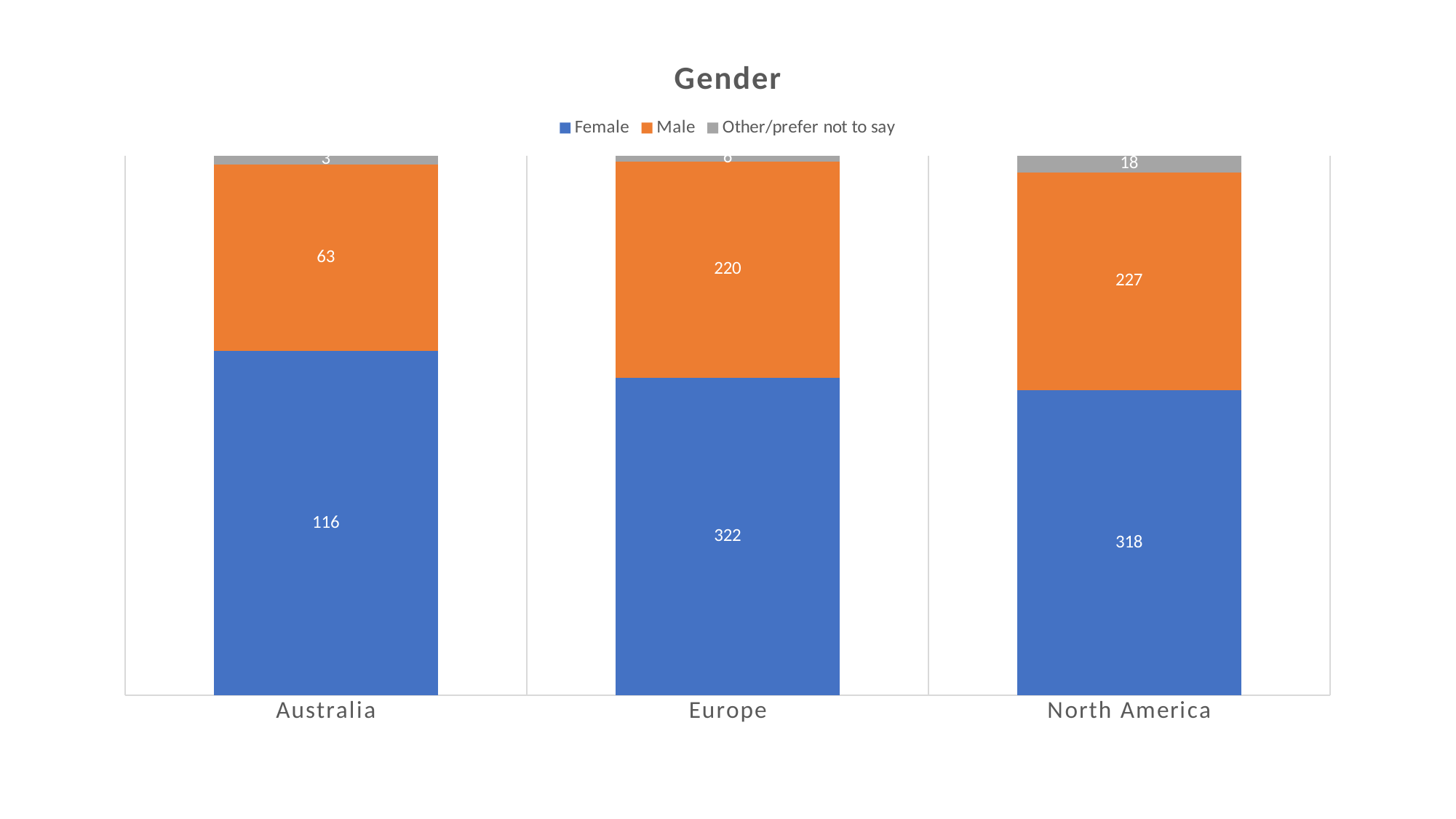
How many series does the legend list? 3 What is the total of the stacked bar for North America? 563 Which is larger, the Male value for Europe or the Male value for North America? North America How many regions are shown on the x axis? 3 What is the difference between the Male values for North America and Australia? 164 What is the Female value for Australia? 116 What is the difference between the Female values for Europe and North America? 4 What is the Other/prefer not to say value for North America? 18 Which region has the lowest Male value? Australia What is the Male value for North America? 227 What is the Male value for Europe? 220 Which region has the highest Female value? Europe